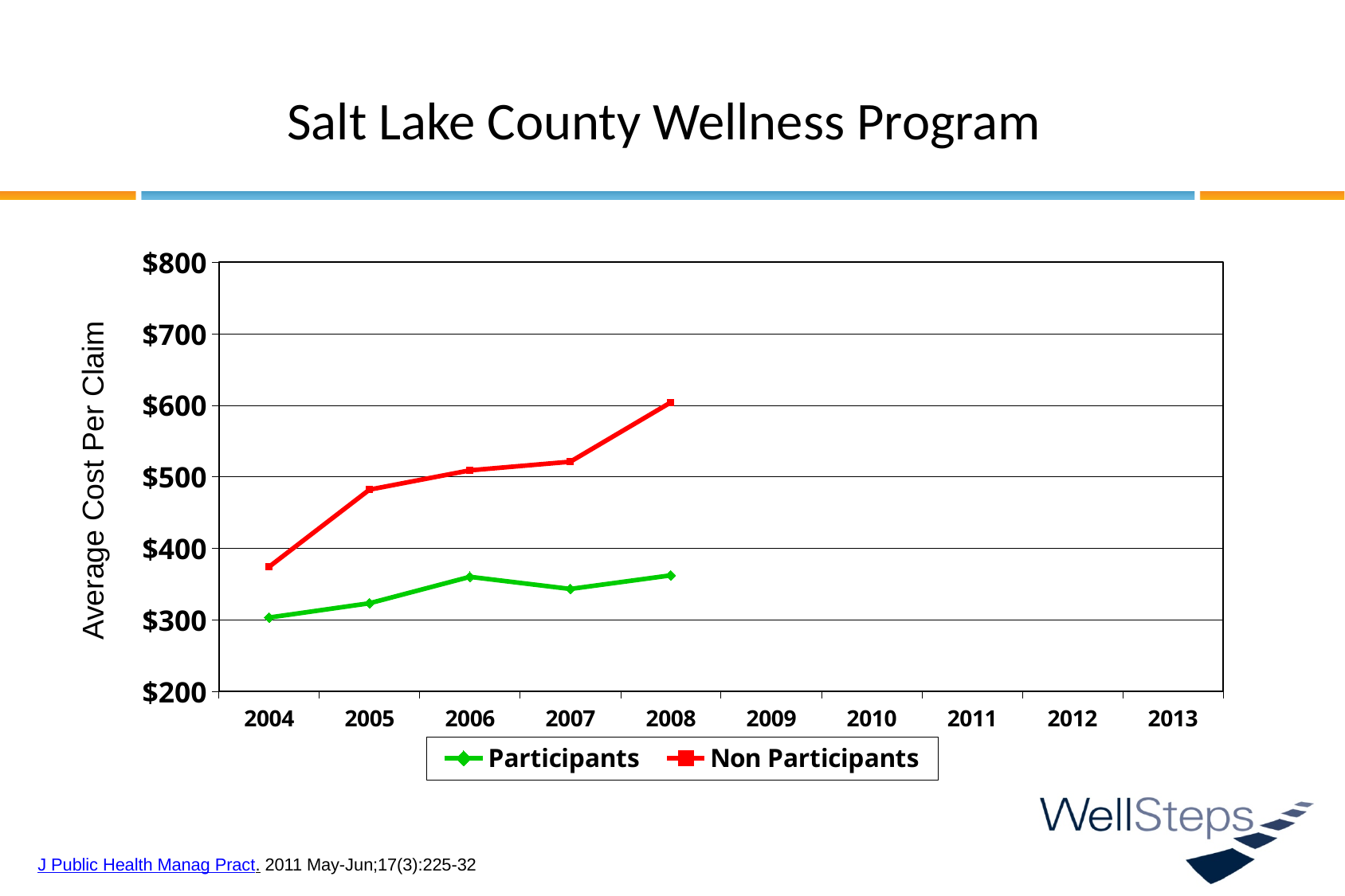
What kind of chart is shown on the slide? line chart In which year is the Participants value lowest? 2004 Is the Non Participants value for 2008 greater or less than $500? greater What is the title of the vertical axis? Average Cost Per Claim How many series does the legend list? 2 In 2008, which series has the larger value, Participants or Non Participants? Non Participants What colour is the Non Participants line? red Is the Non Participants value for 2004 greater or less than $400? less In which year is the Non Participants value highest? 2008 How many years have data points plotted for the Participants series? 5 Does the Non Participants line rise or fall from 2004 to 2008? rise Is the Participants value for 2008 greater or less than $400? less